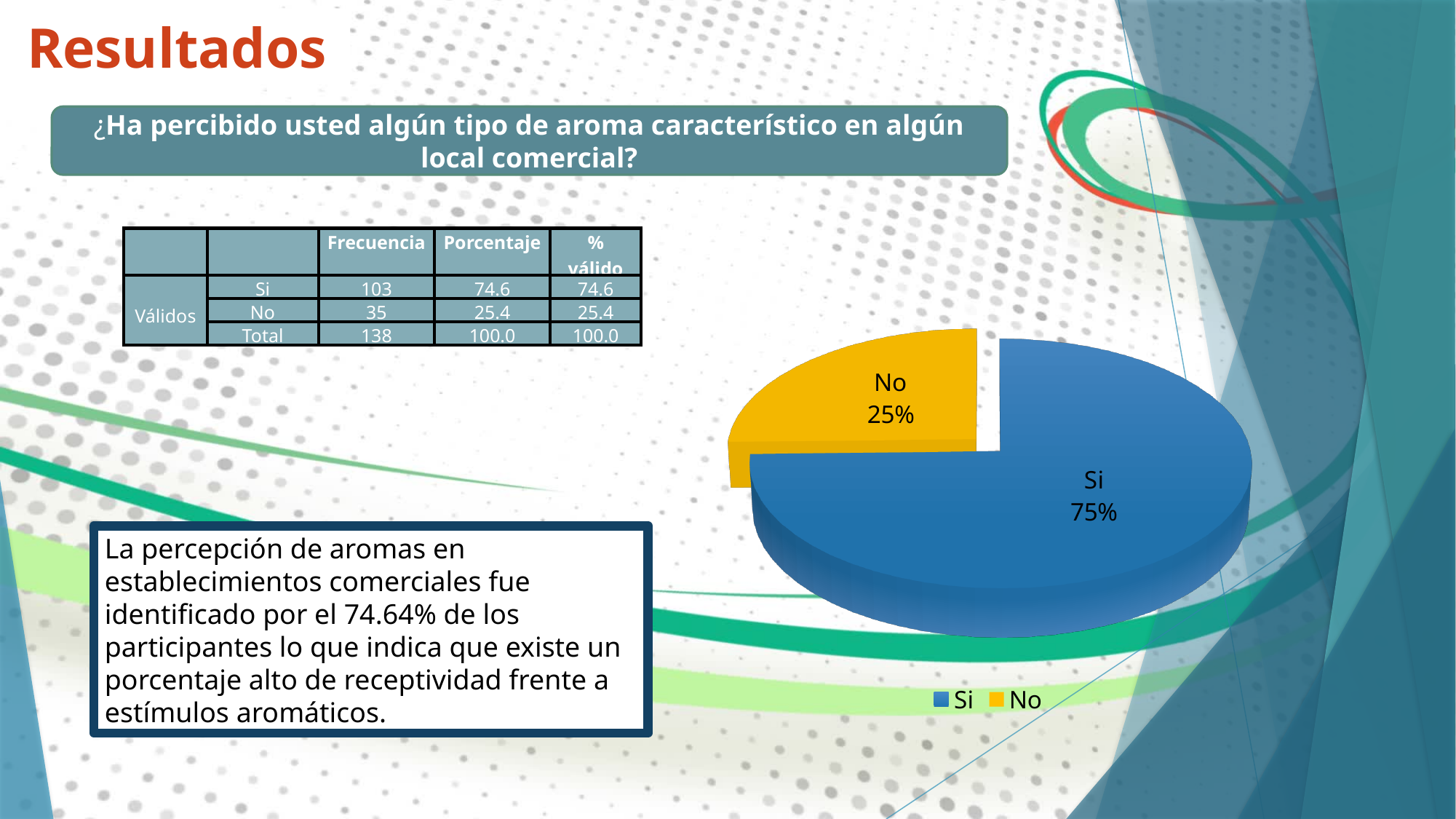
What kind of chart is shown on the slide? pie chart How many entries does the pie chart legend list? 2 Which is larger in the pie chart, 'Si' or 'No'? Si What is the difference in percentage points between the 'Si' and 'No' slices? 50 What percentage does the 'No' slice of the pie chart show? 25% What colour is the 'No' slice in the pie chart? yellow Which slice of the pie chart is the largest? Si How many slices does the pie chart have? 2 Which slice of the pie chart is the smallest? No What colour is the 'Si' slice in the pie chart? blue What percentage does the 'Si' slice of the pie chart show? 75%